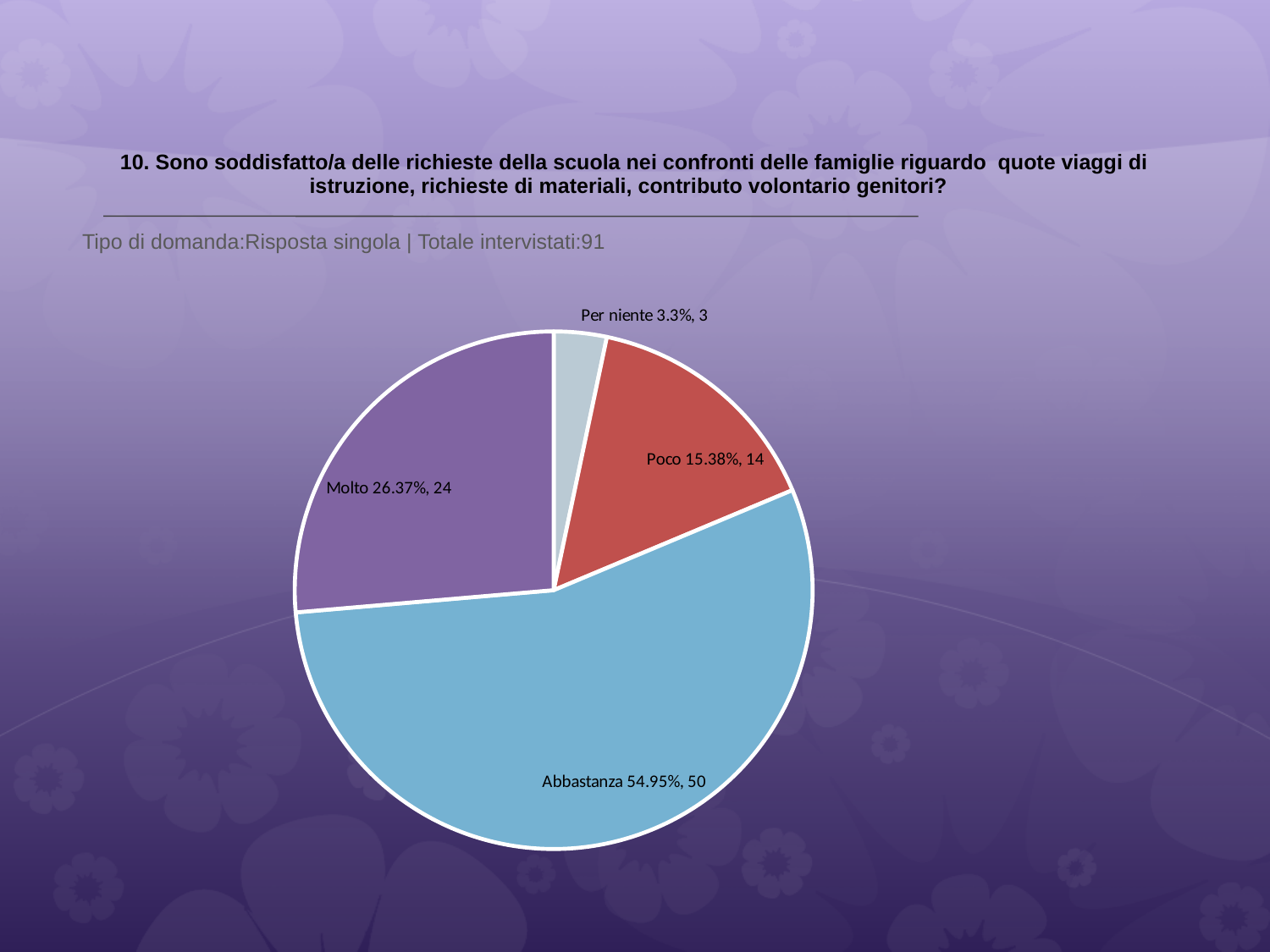
How many respondents answered 'Molto'? 24 What percentage share does the 'Per niente' slice have? 3.3% What colour is the 'Abbastanza' slice? light blue How many slices does the pie chart have? 4 Which category has the largest slice? Abbastanza How many respondents answered 'Poco'? 14 What is the difference in respondent count between 'Abbastanza' and 'Molto'? 26 Which has more respondents, 'Poco' or 'Molto'? Molto What is the total number of respondents across all slices? 91 What percentage share does the 'Abbastanza' slice have? 54.95% Which category has the smallest slice? Per niente What kind of chart is shown on the slide? pie chart